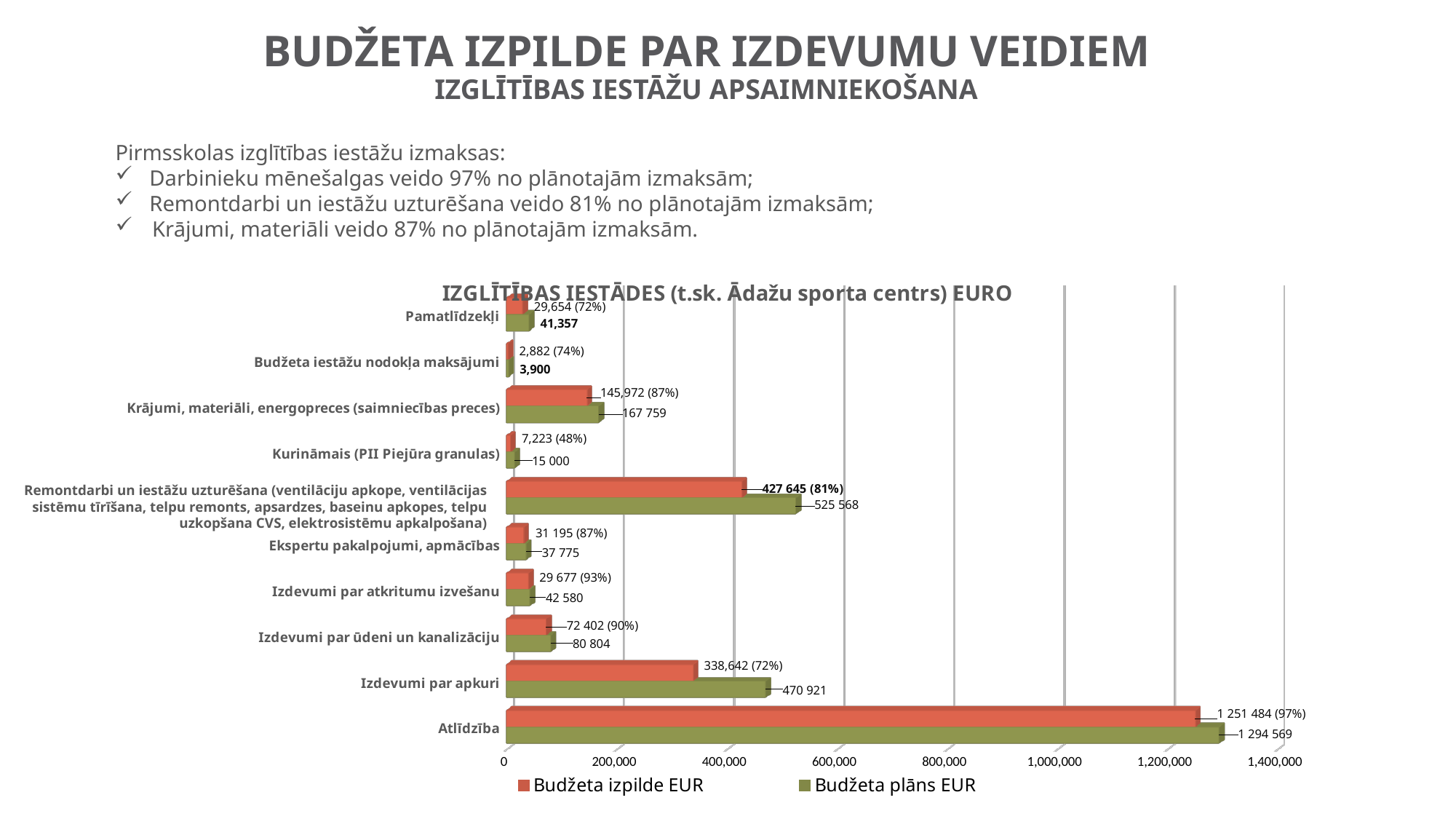
How many categories are shown on the chart? 10 Which category has the lowest Budžeta izpilde EUR value? Budžeta iestāžu nodokļa maksājumi What type of chart is shown on the slide? bar chart What is the Budžeta plāns EUR value for Izdevumi par apkuri? 470 921 What is the Budžeta izpilde EUR value for Atlīdzība? 1 251 484 Which category has the highest Budžeta plāns EUR value? Atlīdzība Is the Budžeta plāns EUR value for Remontdarbi un iestāžu uzturēšana greater or less than 400,000? greater Which is larger for Izdevumi par apkuri: the Budžeta izpilde EUR value or the Budžeta plāns EUR value? Budžeta plāns EUR What is the difference between the Budžeta plāns EUR and Budžeta izpilde EUR values for Izdevumi par ūdeni un kanalizāciju? 8 402 What percentage of the plan is shown next to the Budžeta izpilde EUR value for Izdevumi par atkritumu izvešanu? 93% What is the Budžeta plāns EUR value for Kurināmais (PII Piejūra granulas)? 15 000 How many series does the legend list? 2